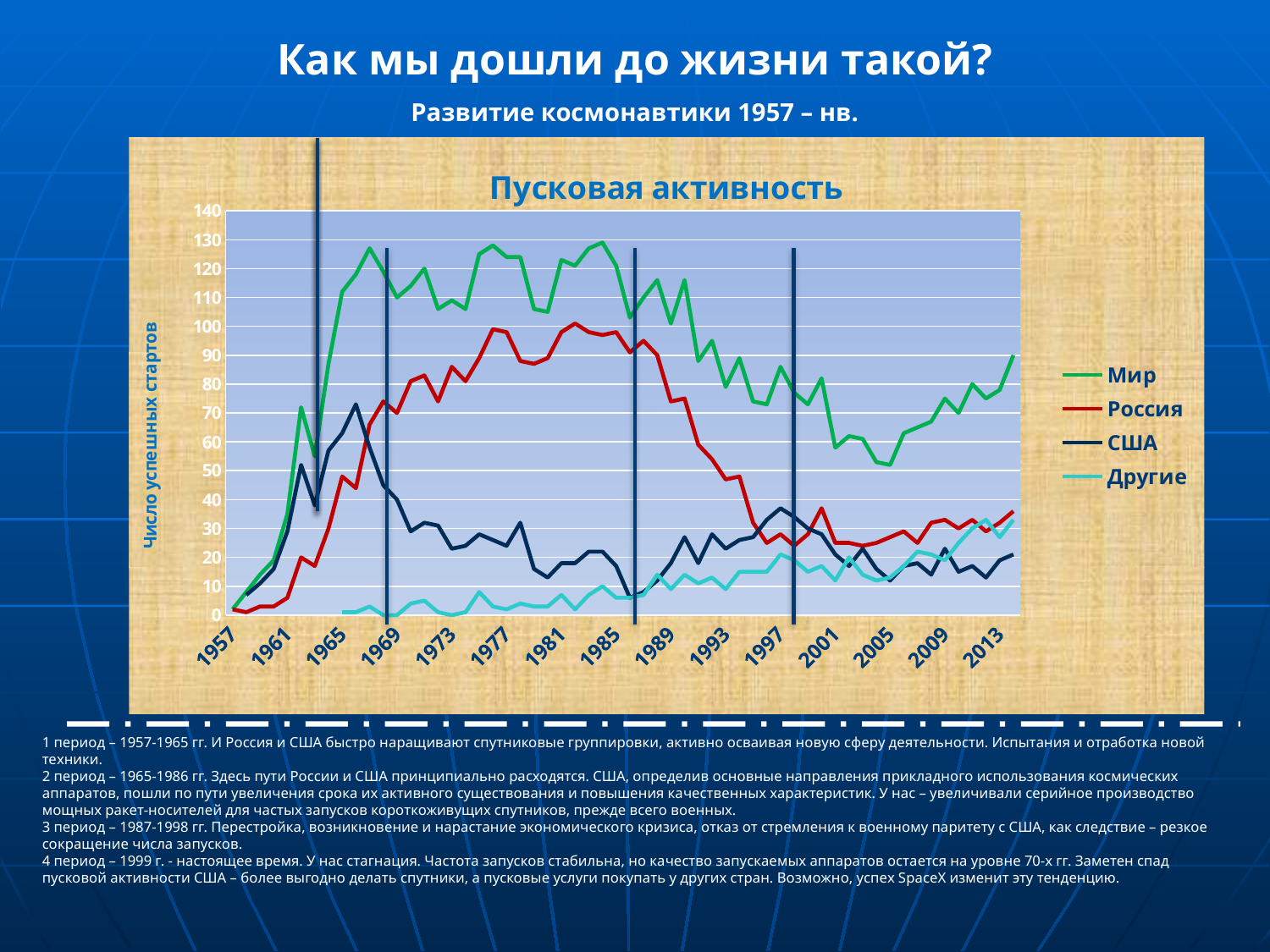
Is the value for Мир in 1977 greater or less than 100? greater Is the value for Россия in 1993 greater or less than 60? less In 1969, which series has the larger value, Россия or США? Россия What is the label of the vertical axis of the chart? Число успешных стартов Is the value for США in 1985 greater or less than 40? less What is the title of the chart? Пусковая активность How many series does the legend of the chart list? 4 Does the value for Россия rise or fall between 1985 and 1997? fall Which series has the lowest value in 1977? Другие What kind of chart is shown on the slide? line chart